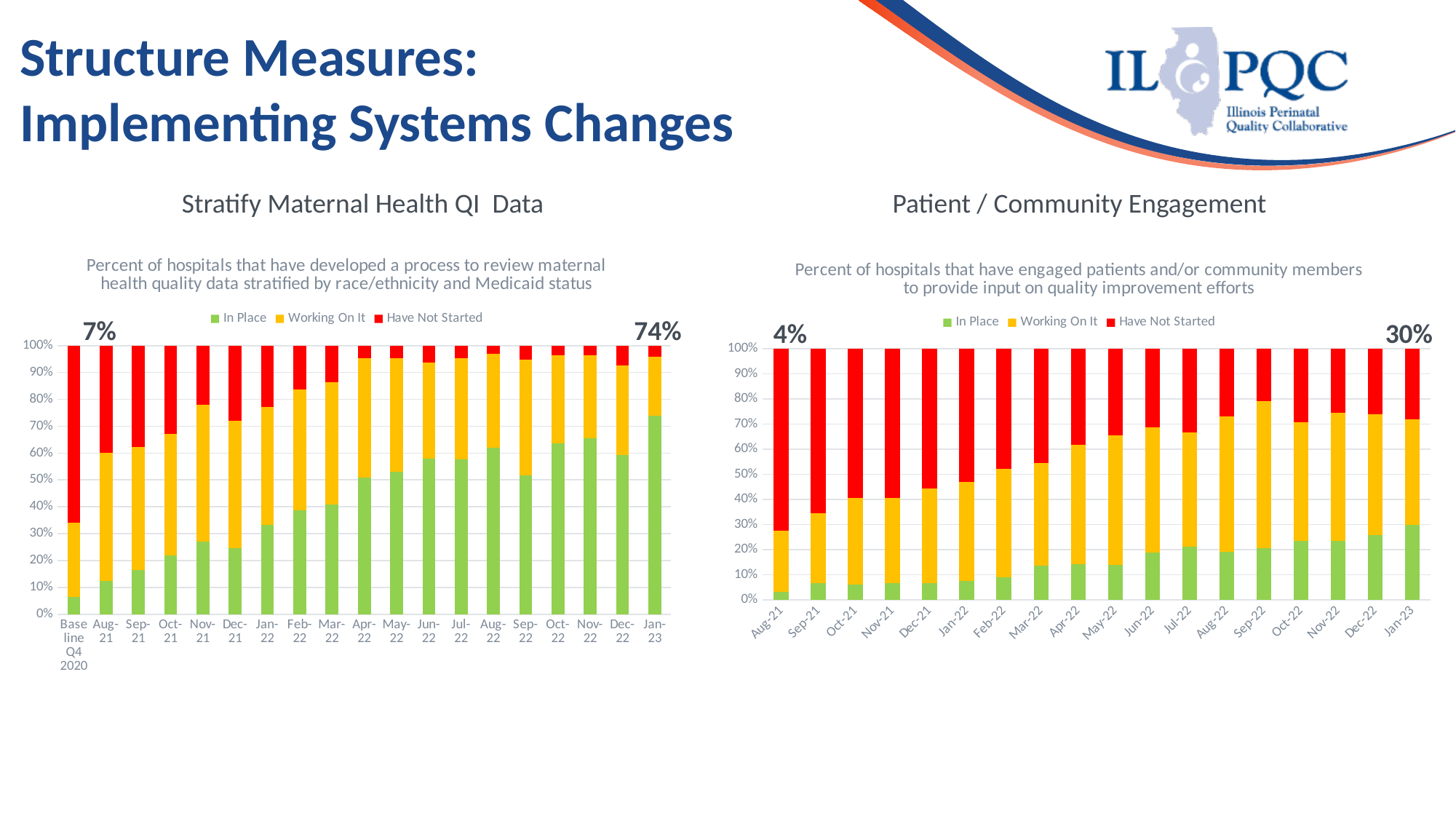
In the Stratify Maternal Health QI Data chart, is the In Place value for Jun-22 greater or less than 50%? greater How many time periods are shown on the x axis of the Patient / Community Engagement chart? 18 In the Patient / Community Engagement chart, by how many percentage points did the labelled In Place value increase from Aug-21 to Jan-23? 26 percentage points In the Patient / Community Engagement chart, what is the In Place value labelled for Jan-23? 30% What type of chart is the Patient / Community Engagement chart? Stacked bar chart In the Patient / Community Engagement chart, which month has the highest In Place share? Jan-23 How many series does the legend of the Stratify Maternal Health QI Data chart list? 3 In the Stratify Maternal Health QI Data chart, what is the In Place value labelled for Jan-23? 74% In the Stratify Maternal Health QI Data chart, what is the In Place value labelled for the Baseline Q4 2020 bar? 7% In the Patient / Community Engagement chart, what is the In Place value labelled for Aug-21? 4% In the Stratify Maternal Health QI Data chart, by how many percentage points did the labelled In Place value increase from Baseline Q4 2020 to Jan-23? 67 percentage points In the Stratify Maternal Health QI Data chart, does the In Place share generally rise or fall from Baseline Q4 2020 to Jan-23? Rise